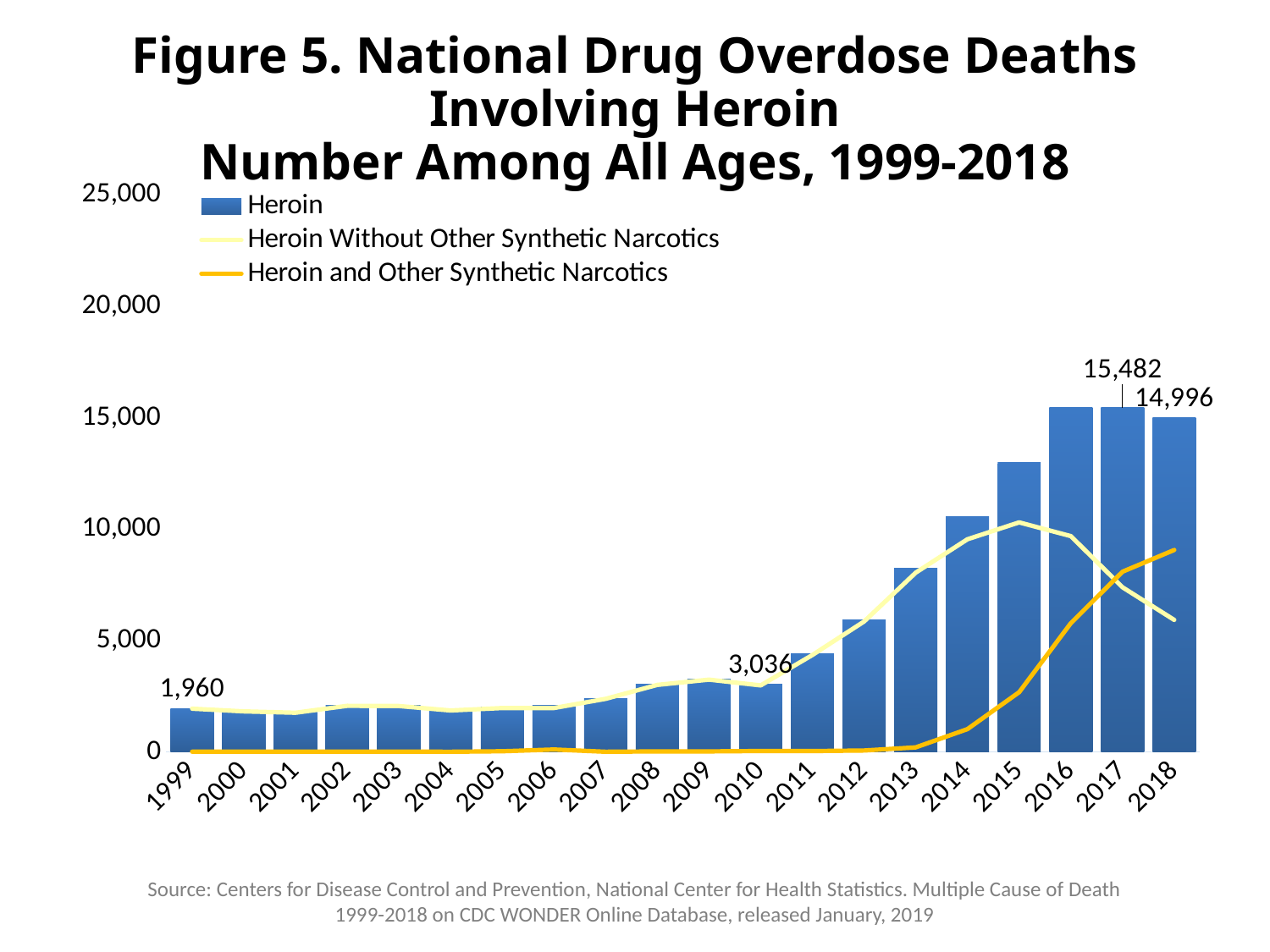
How many series does the legend list? 3 What is the difference between the Heroin values for 2010 and 1999? 1,076 What is the difference between the Heroin values for 2017 and 2018? 486 What is the value for Heroin in 1999? 1,960 What is the value for Heroin in 2017? 15,482 Do the Heroin bars rise or fall from 2010 to 2017? rise What is the value for Heroin in 2018? 14,996 How many years are shown on the x axis? 20 Is the Heroin Without Other Synthetic Narcotics value for 2018 greater or less than 10,000? less Is the Heroin value for 2015 greater or less than 10,000? greater Which year has the larger Heroin value, 2017 or 2018? 2017 What is the value for Heroin in 2010? 3,036